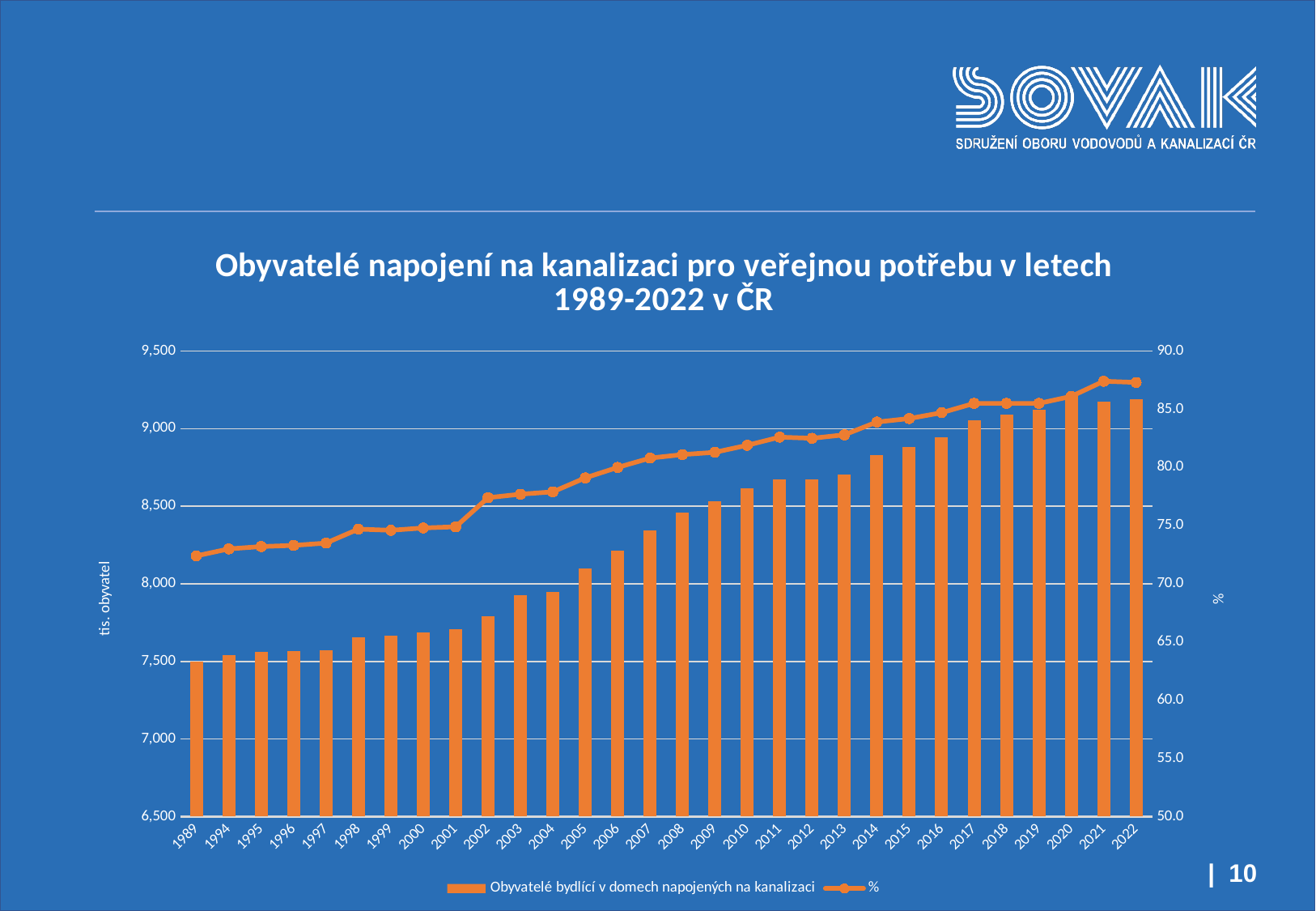
Do the bar values generally rise or fall from 1989 to 2022? Rise Is the bar value for 2010 greater or less than 8,500? greater Is the % line value for 2022 greater or less than 85.0? greater How many years are shown on the x axis? 30 Is the bar value for 2003 greater or less than 8,000? less What is the label of the left vertical axis? tis. obyvatel Which is larger, the bar value for 2000 or the bar value for 2015? 2015 How many series does the legend list? 2 Which year has the lowest bar for Obyvatelé bydlící v domech napojených na kanalizaci? 1989 What kind of chart is shown on the slide? A combined bar and line chart